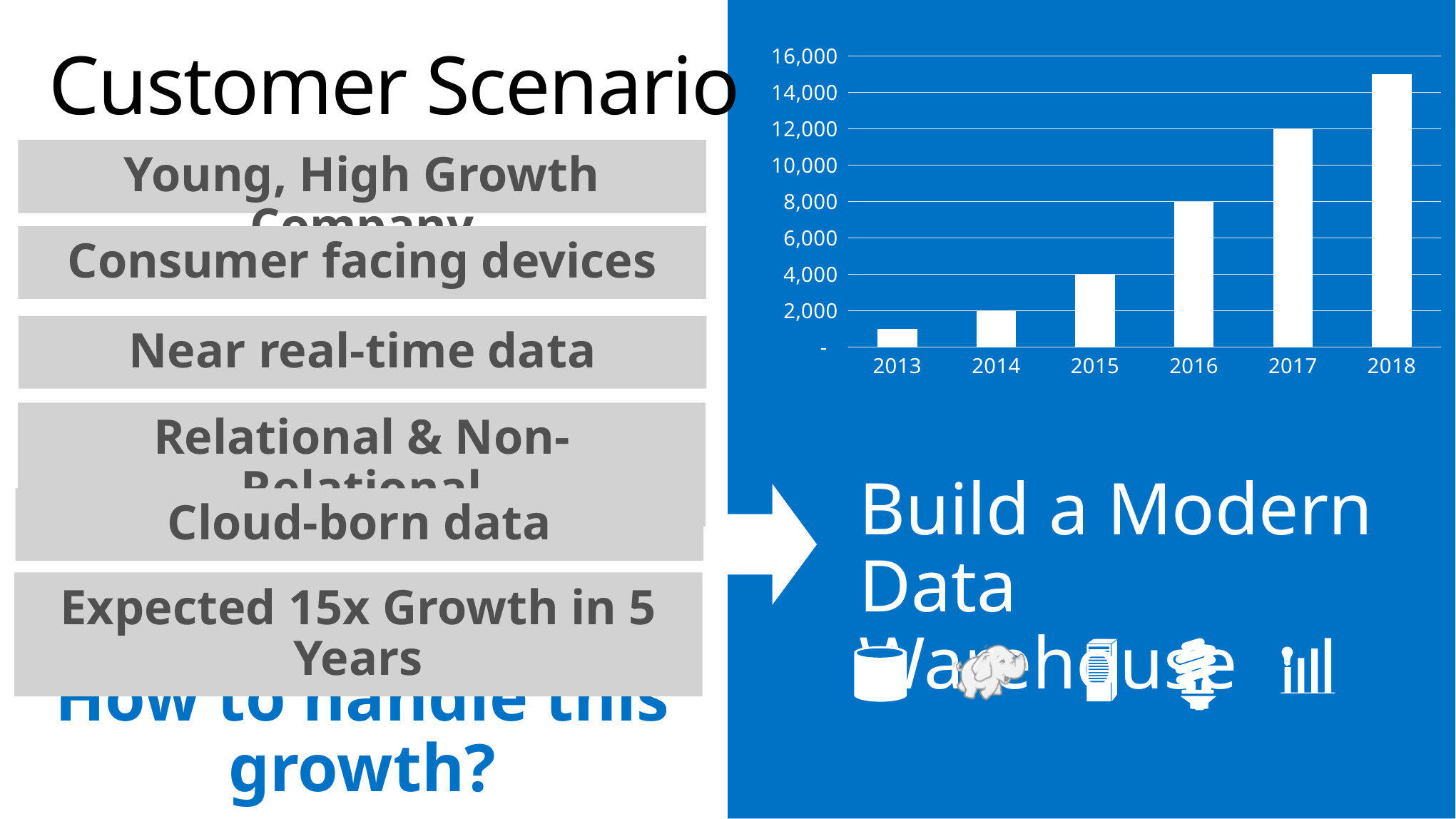
Is the value for 2013 greater or less than 2,000? less What is the value for 2017 in the chart? 12,000 What kind of chart is shown on the slide? bar chart What is the value for 2016 in the chart? 8,000 Do the values in the chart rise or fall from 2013 to 2018? rise How many years are shown on the x axis of the chart? 6 What is the value for 2015 in the chart? 4,000 What is the value for 2014 in the chart? 2,000 Is the value for 2018 greater or less than 14,000? greater Which is larger, the value for 2016 or the value for 2015? 2016 Which year has the highest bar in the chart? 2018 Which year has the lowest bar in the chart? 2013